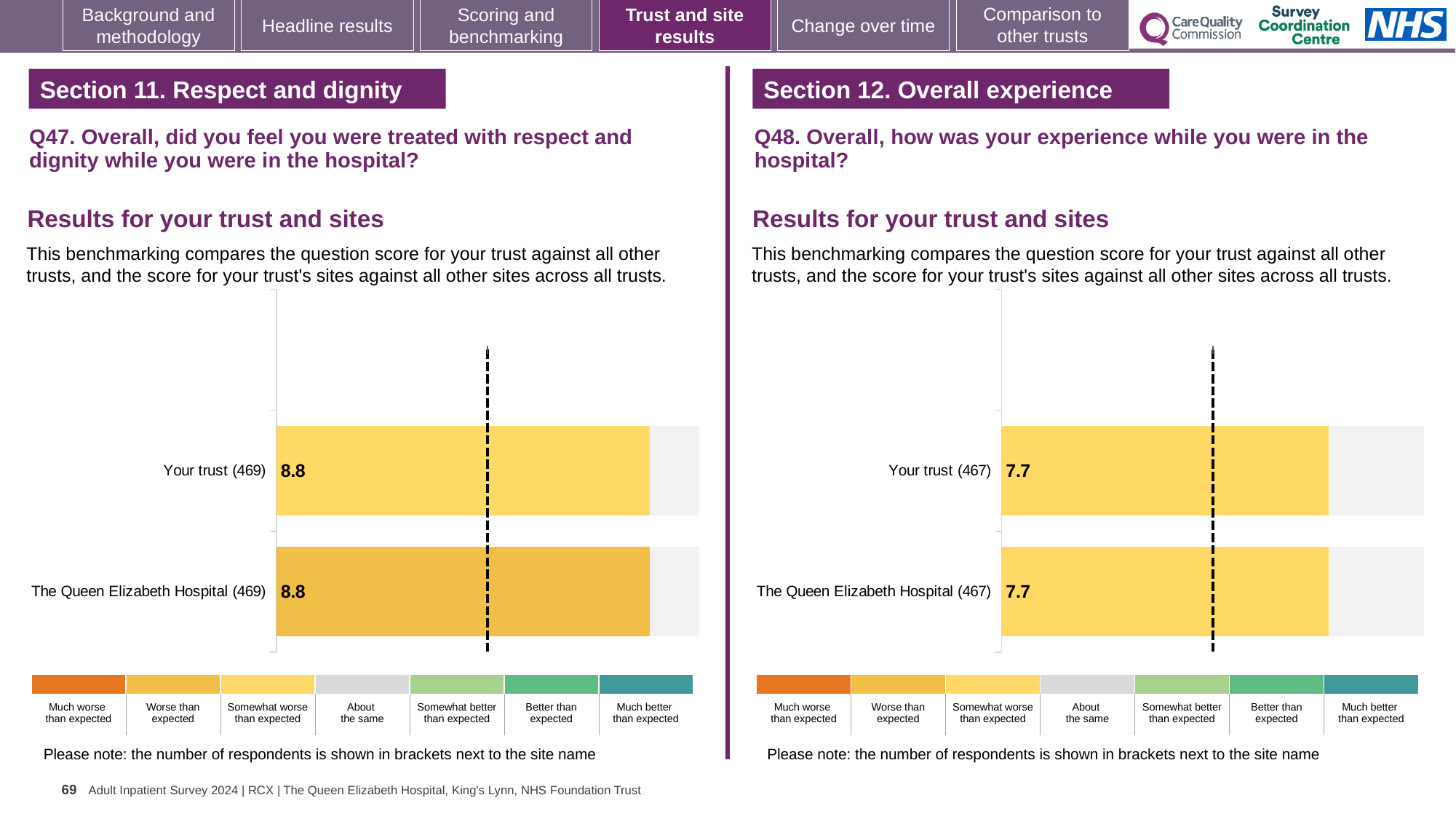
On the Q48 chart (right), what is the score for Your trust? 7.7 What kind of chart is used on the Q47 chart (left)? Bar chart How many bars are plotted on the Q48 chart (right)? 2 On the Q47 chart (left), what is the score for The Queen Elizabeth Hospital? 8.8 On the Q47 chart (left), what is the score for Your trust? 8.8 On the Q48 chart (right), what is the difference between the score for Your trust and the score for The Queen Elizabeth Hospital? 0 Is the score for Your trust on the Q47 chart (left) larger than the score for Your trust on the Q48 chart (right)? Yes On the Q48 chart (right), how many respondents are shown in brackets next to The Queen Elizabeth Hospital? 467 On the Q47 chart (left), how many respondents are shown in brackets next to Your trust? 469 On the Q48 chart (right), what is the score for The Queen Elizabeth Hospital? 7.7 How many bars are plotted on the Q47 chart (left)? 2 On the Q47 chart (left), what is the difference between the score for Your trust and the score for The Queen Elizabeth Hospital? 0